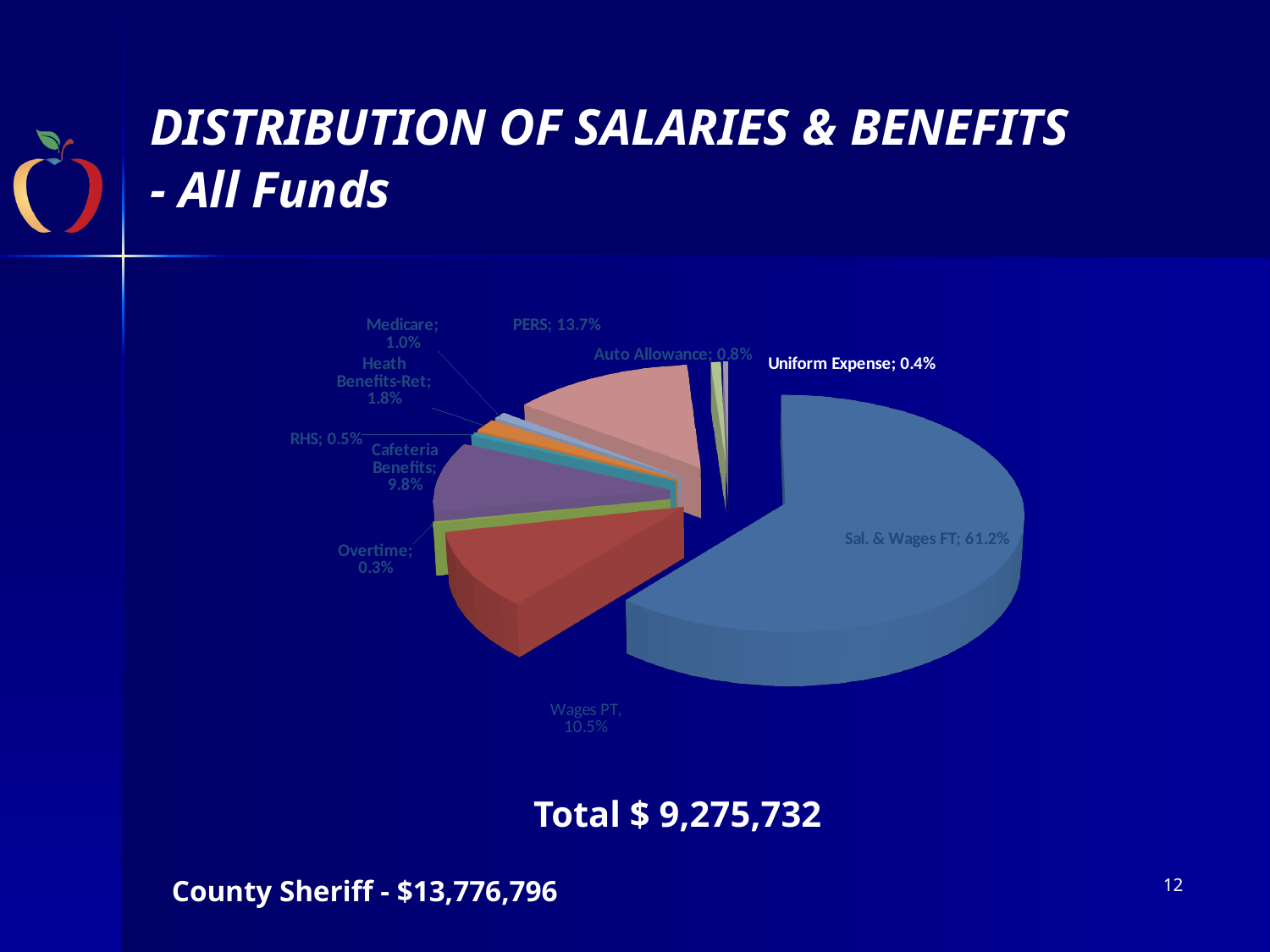
Which category has the smallest slice of the pie? Overtime What percentage is shown for Wages PT? 10.5% What percentage is shown for PERS? 13.7% How many slices does the pie chart have? 10 What kind of chart is shown on the slide? pie chart What share of the pie does Sal. & Wages FT represent? 61.2% What is the title of the slide containing the chart? DISTRIBUTION OF SALARIES & BENEFITS - All Funds Which category has the largest slice of the pie? Sal. & Wages FT What total amount is shown below the pie chart? $ 9,275,732 What percentage is shown for Cafeteria Benefits? 9.8% What is the difference in percentage points between Sal. & Wages FT and PERS? 47.5 Which is larger, the share for PERS or the share for Wages PT? PERS